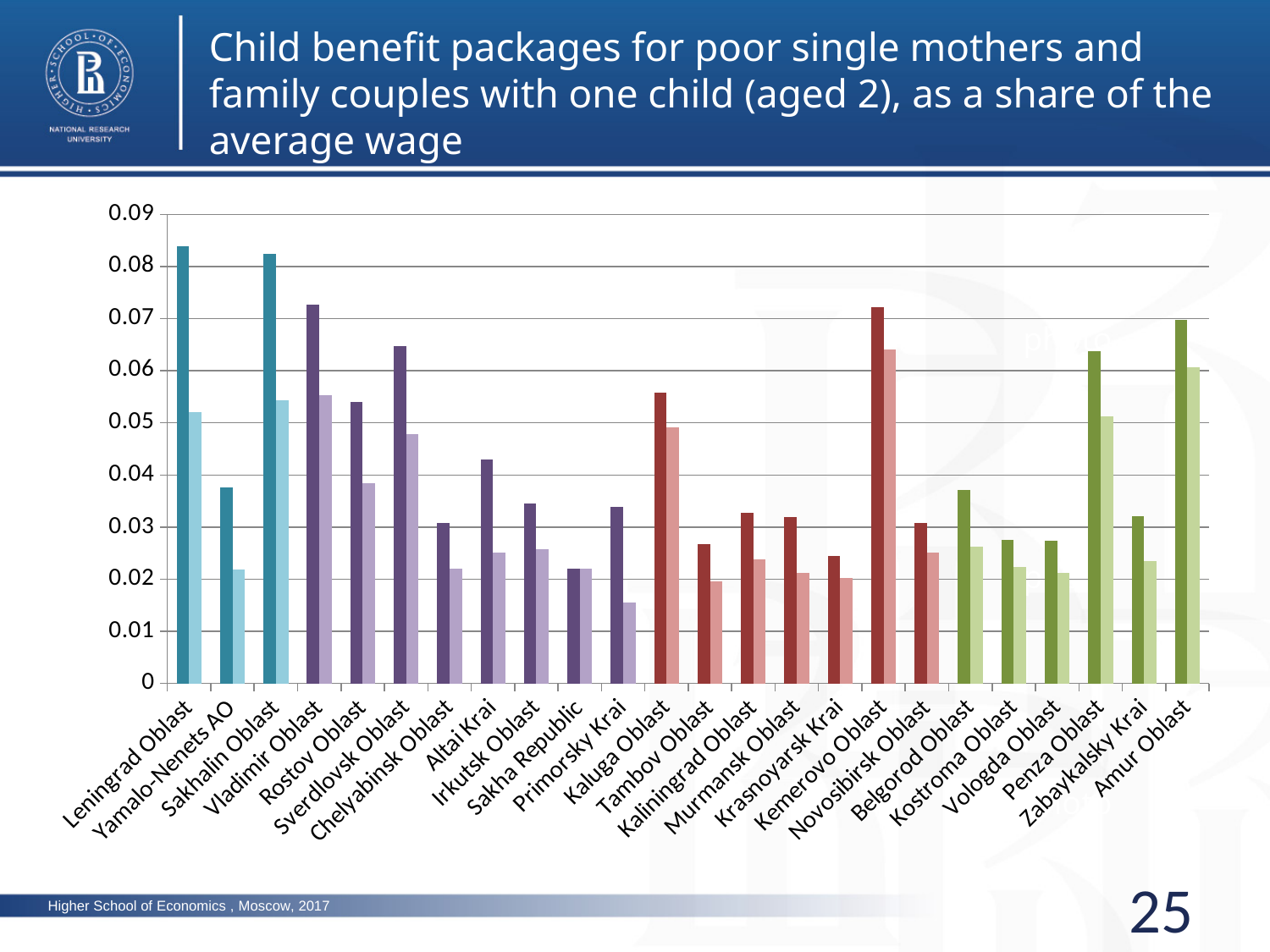
Is the value of the lighter bar for Primorsky Krai greater or less than 0.02? less What kind of chart is shown on the slide? bar chart Which is larger: the darker bar for Leningrad Oblast or the darker bar for Vladimir Oblast? Leningrad Oblast Which is larger: the darker bar for Kemerovo Oblast or the darker bar for Kaluga Oblast? Kemerovo Oblast How many bars are plotted for each region in the chart? 2 Is the value of the darker bar for Vladimir Oblast greater or less than 0.07? greater Is the value of the darker bar for Belgorod Oblast greater or less than 0.03? greater Which region has the lowest lighter bar in the chart? Primorsky Krai How many regions are shown along the x axis of the chart? 24 What is the title of the slide containing the chart? Child benefit packages for poor single mothers and family couples with one child (aged 2), as a share of the average wage